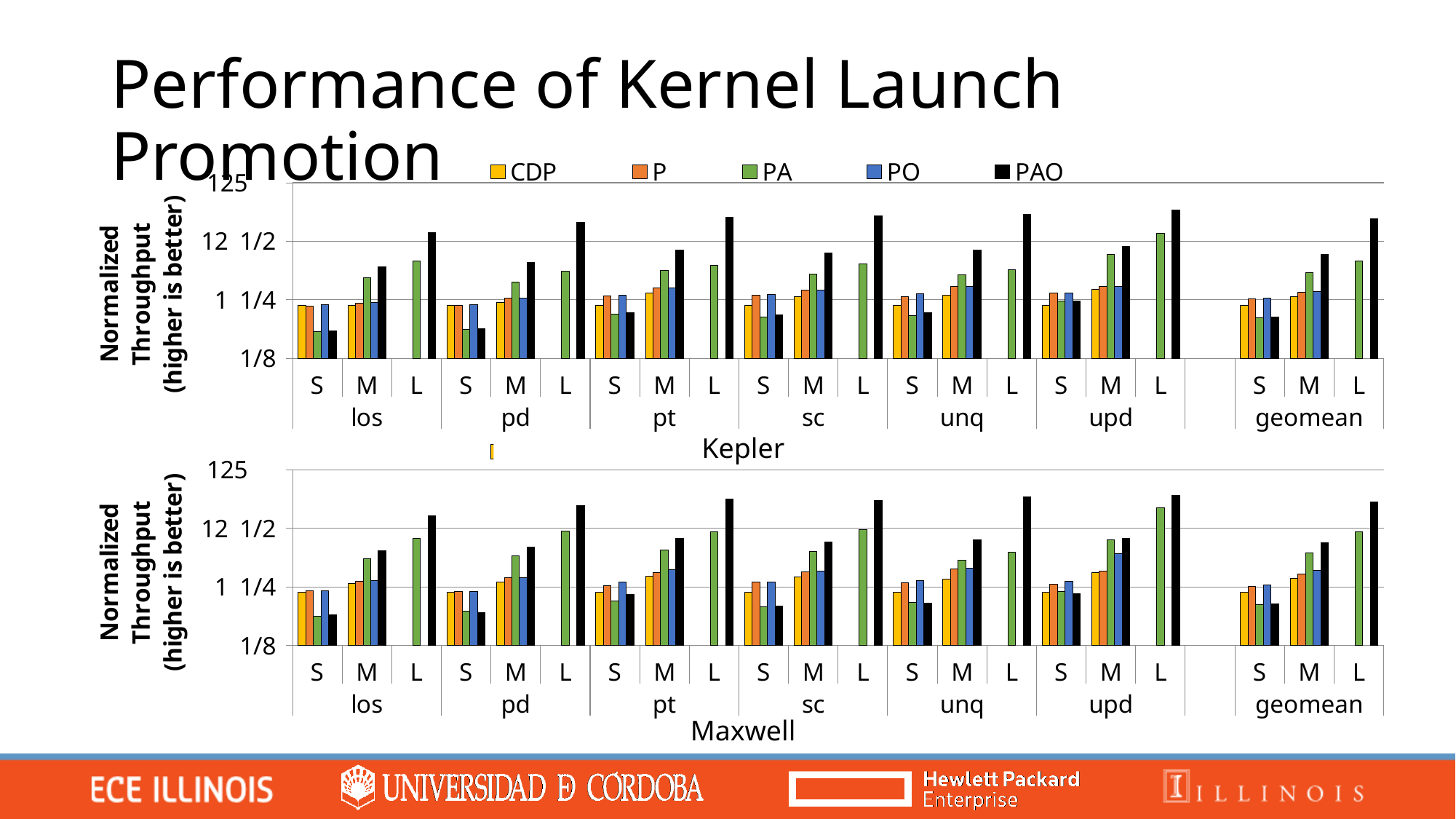
In the Kepler chart, is the PA value for unq S greater or less than 1 1/4? less In the Kepler chart, which series has the highest bar for upd L? PAO What are the series names in the legend? CDP, P, PA, PO, PAO In the Maxwell chart, for sc M, which is larger: the PA bar or the P bar? PA In the Kepler chart, for pt M, which is larger: the CDP bar or the PAO bar? PAO How many series does the legend list for the charts? 5 How many benchmark groups (including geomean) are shown along the x axis of the Maxwell chart? 7 In the Maxwell chart, is the PA value for upd L greater or less than 12 1/2? greater In the Kepler chart, is the PAO value for upd L greater or less than 12 1/2? greater In the Maxwell chart, which series has the highest bar for geomean L? PAO What is the y-axis label of the Kepler chart? Normalized Throughput (higher is better) What kind of chart is the Kepler chart? bar chart